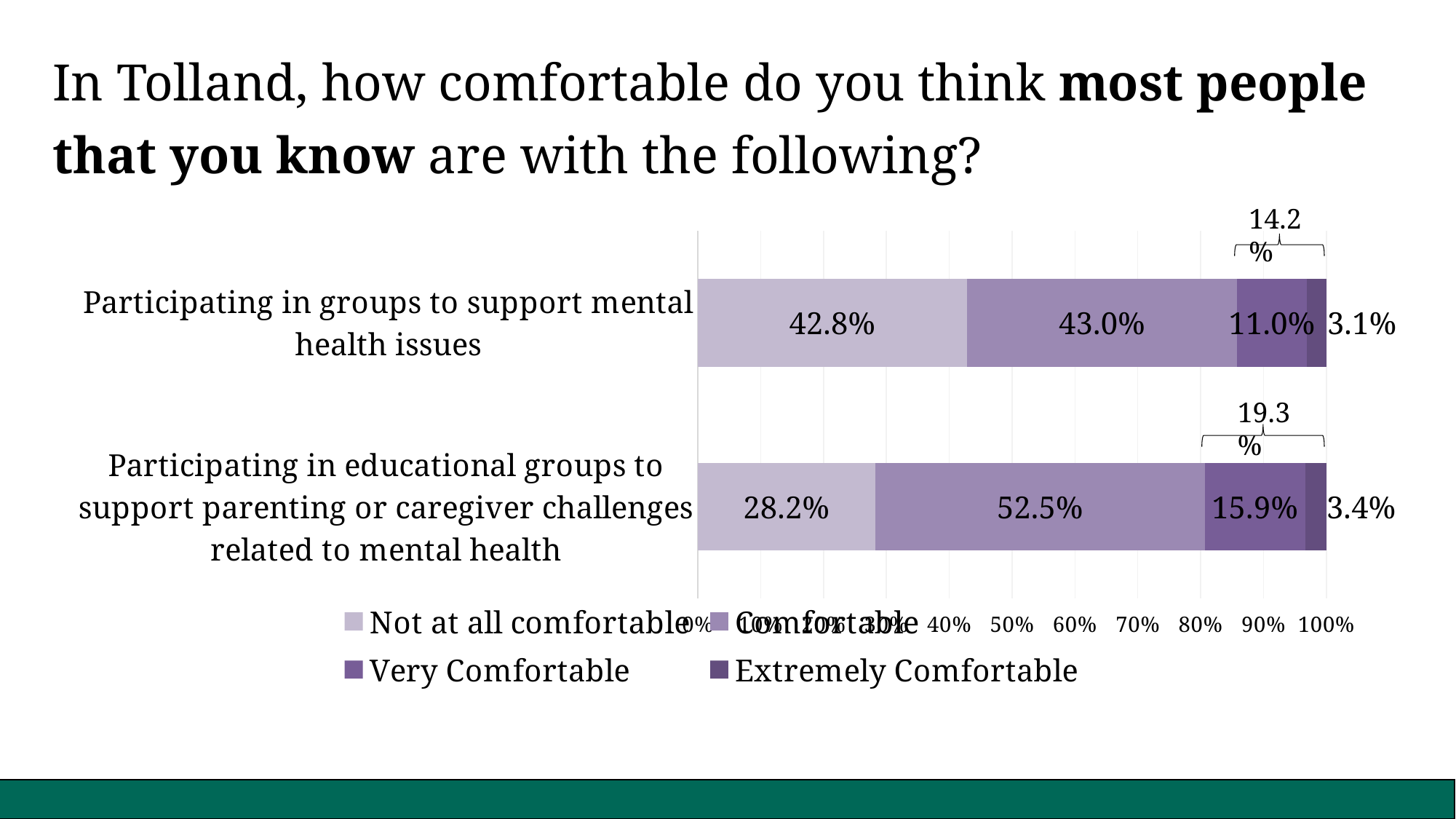
How many categories are plotted on the chart? 2 How many series does the legend list? 4 Which category has the higher 'Not at all comfortable' value? Participating in groups to support mental health issues What kind of chart is shown on the slide? Stacked bar chart What combined percentage is shown by the bracket above the bar for participating in educational groups to support parenting or caregiver challenges? 19.3% What is the 'Very Comfortable' value for participating in groups to support mental health issues? 11.0% What is the difference between the 'Very Comfortable' values for the two categories? 4.9% What percentage of respondents think most people they know are 'Not at all comfortable' participating in groups to support mental health issues? 42.8% What is the 'Extremely Comfortable' value for participating in educational groups to support parenting or caregiver challenges related to mental health? 3.4% What combined percentage is shown by the bracket above the bar for participating in groups to support mental health issues? 14.2% What is the 'Comfortable' value for participating in educational groups to support parenting or caregiver challenges related to mental health? 52.5% What is the difference between the 'Comfortable' values for the two categories? 9.5%